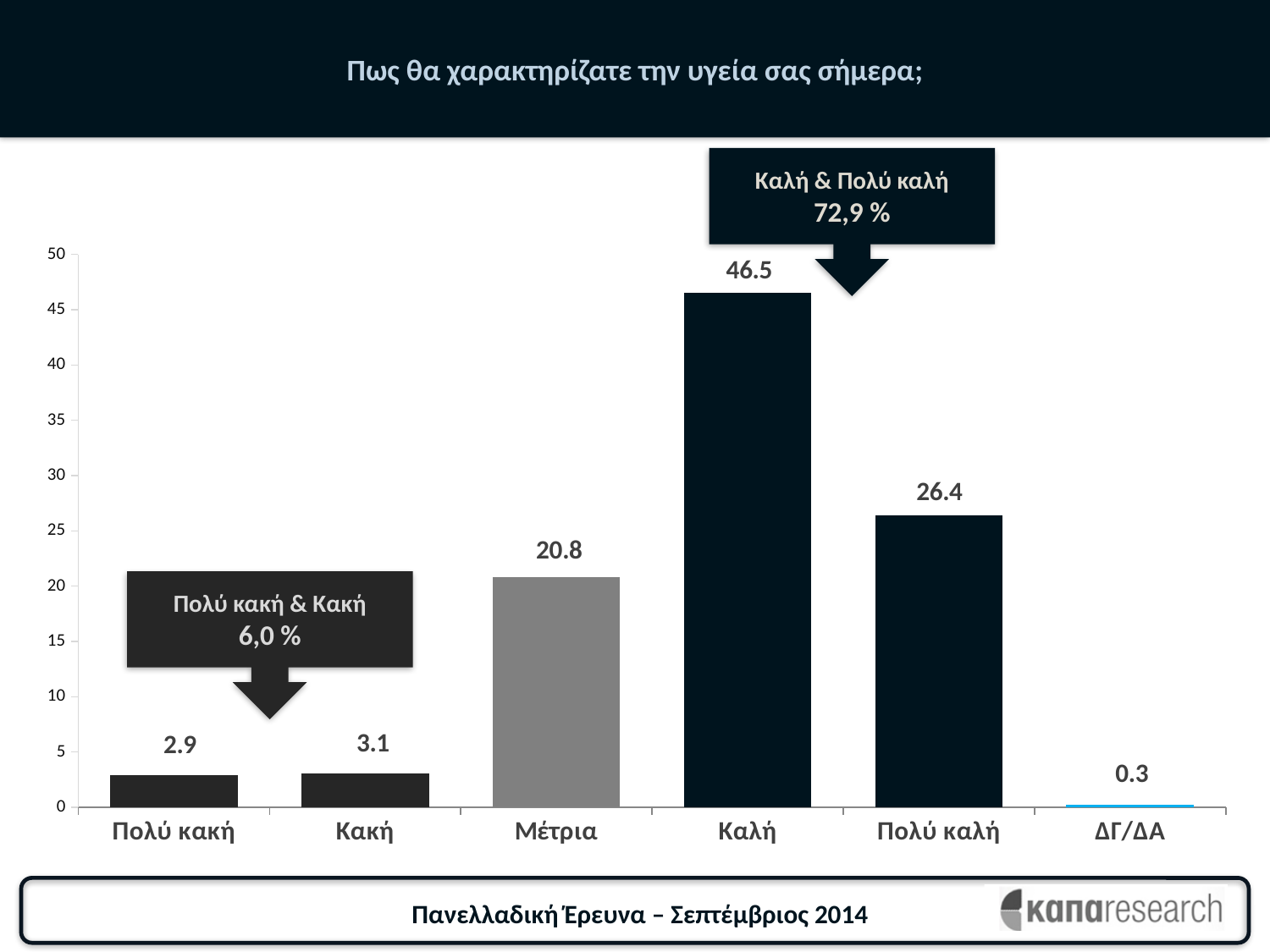
What is the value for Μέτρια? 20.8 What is the difference between the values for Καλή and Πολύ καλή? 20.1 What is the value for ΔΓ/ΔΑ? 0.3 What is the value for Καλή? 46.5 What kind of chart is shown on the slide? bar chart What combined percentage does the callout give for Πολύ κακή & Κακή? 6,0 % Is the value for Πολύ καλή greater or less than 25? greater Which category has the lowest value? ΔΓ/ΔΑ What combined percentage does the callout give for Καλή & Πολύ καλή? 72,9 % Which is larger, the value for Πολύ καλή or the value for Μέτρια? Πολύ καλή Which category has the highest value? Καλή How many categories are shown on the x axis? 6